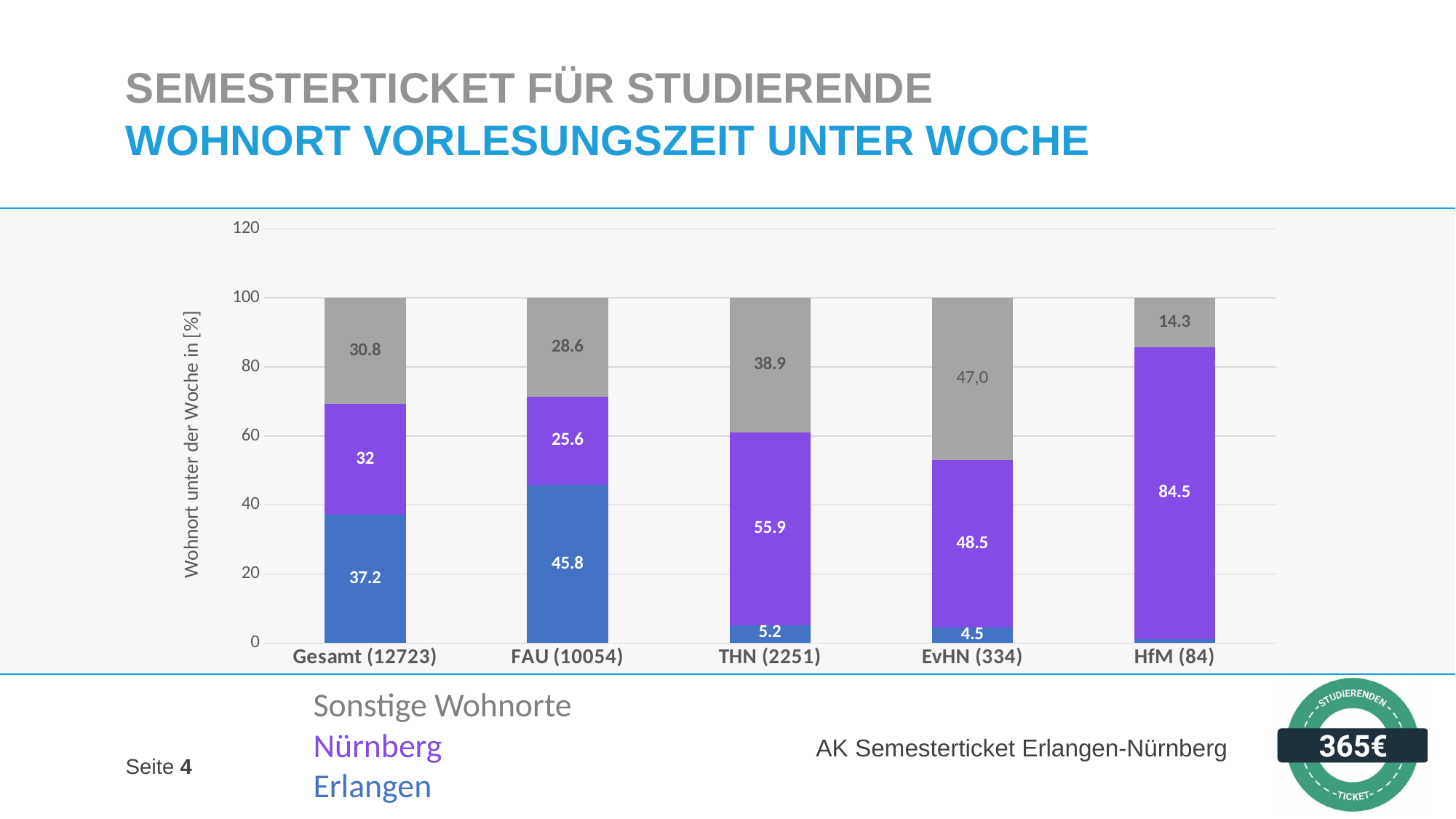
Which is larger: the Nürnberg value for THN (2251) or the Nürnberg value for EvHN (334)? THN (2251) What is the difference between the Erlangen values for FAU (10054) and Gesamt (12723)? 8.6 Which category has the lowest Sonstige Wohnorte value? HfM (84) What type of chart is shown on the slide? stacked bar chart What is the Nürnberg value for Gesamt (12723)? 32 What is the Erlangen value for FAU (10054)? 45.8 What is the Nürnberg value for HfM (84)? 84.5 Which category has the highest Nürnberg value? HfM (84) What is the label of the y axis? Wohnort unter der Woche in [%] How many categories (bars) are shown on the x axis? 5 What is the Sonstige Wohnorte value for THN (2251)? 38.9 How many series does the legend list? 3